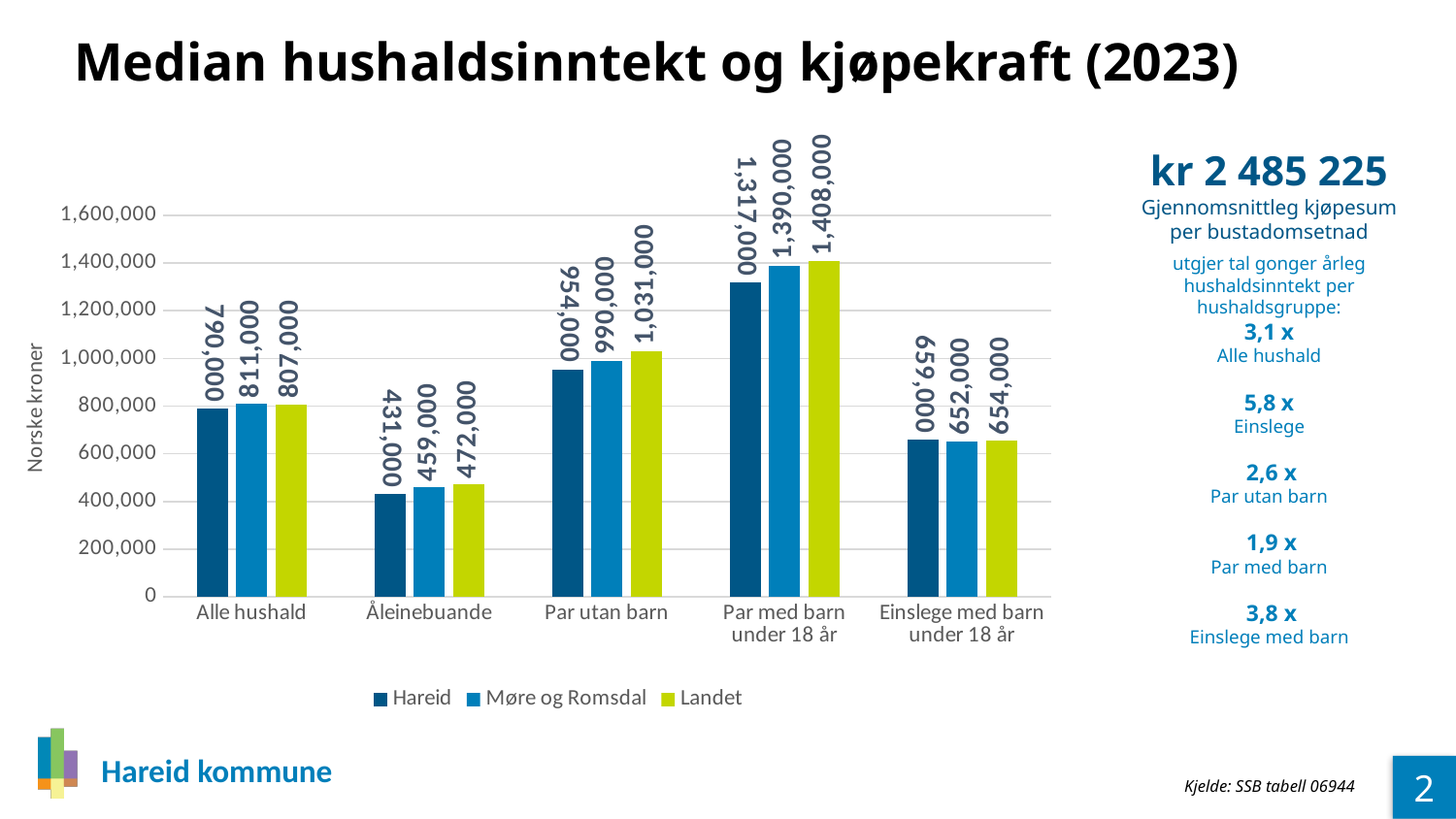
How many series does the legend list? 3 In the Einslege med barn under 18 år category, which is larger: Hareid or Møre og Romsdal? Hareid Is the value for Møre og Romsdal in the Par utan barn category greater or less than 1,000,000? less Which category has the highest value for Hareid? Par med barn under 18 år What is the value for Møre og Romsdal in the Åleinebuande category? 459,000 What is the label of the y axis? Norske kroner What is the value for Landet in the Par med barn under 18 år category? 1,408,000 Which category has the lowest value for Landet? Åleinebuande What is the value for Hareid in the Alle hushald category? 790,000 How many categories are shown on the x axis? 5 What kind of chart is shown on the slide? Bar chart What is the difference between the Landet and Hareid values in the Par utan barn category? 77,000